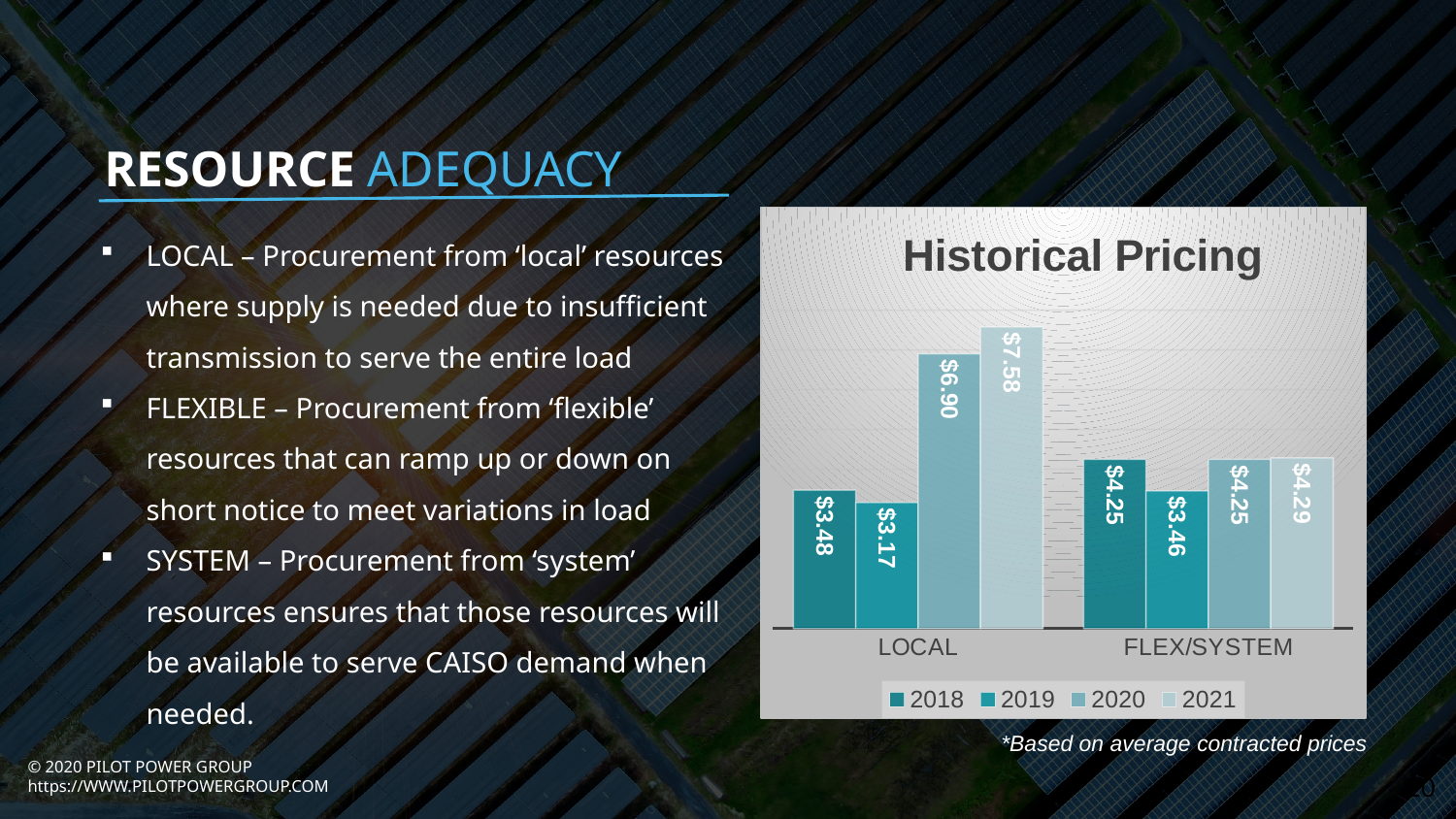
How many series does the legend list? 4 How many categories are shown on the x axis? 2 Which year has the highest value for LOCAL? 2021 What is the 2020 value for LOCAL? $6.90 What is the title of the chart? Historical Pricing Do the LOCAL values rise or fall from 2019 to 2021? rise What is the 2021 value for LOCAL? $7.58 What type of chart is shown on the slide? bar chart What is the difference between the 2021 and 2020 values for LOCAL? $0.68 Which is larger, the 2018 value for LOCAL or the 2018 value for FLEX/SYSTEM? FLEX/SYSTEM Which year has the lowest value for FLEX/SYSTEM? 2019 What is the 2019 value for FLEX/SYSTEM? $3.46